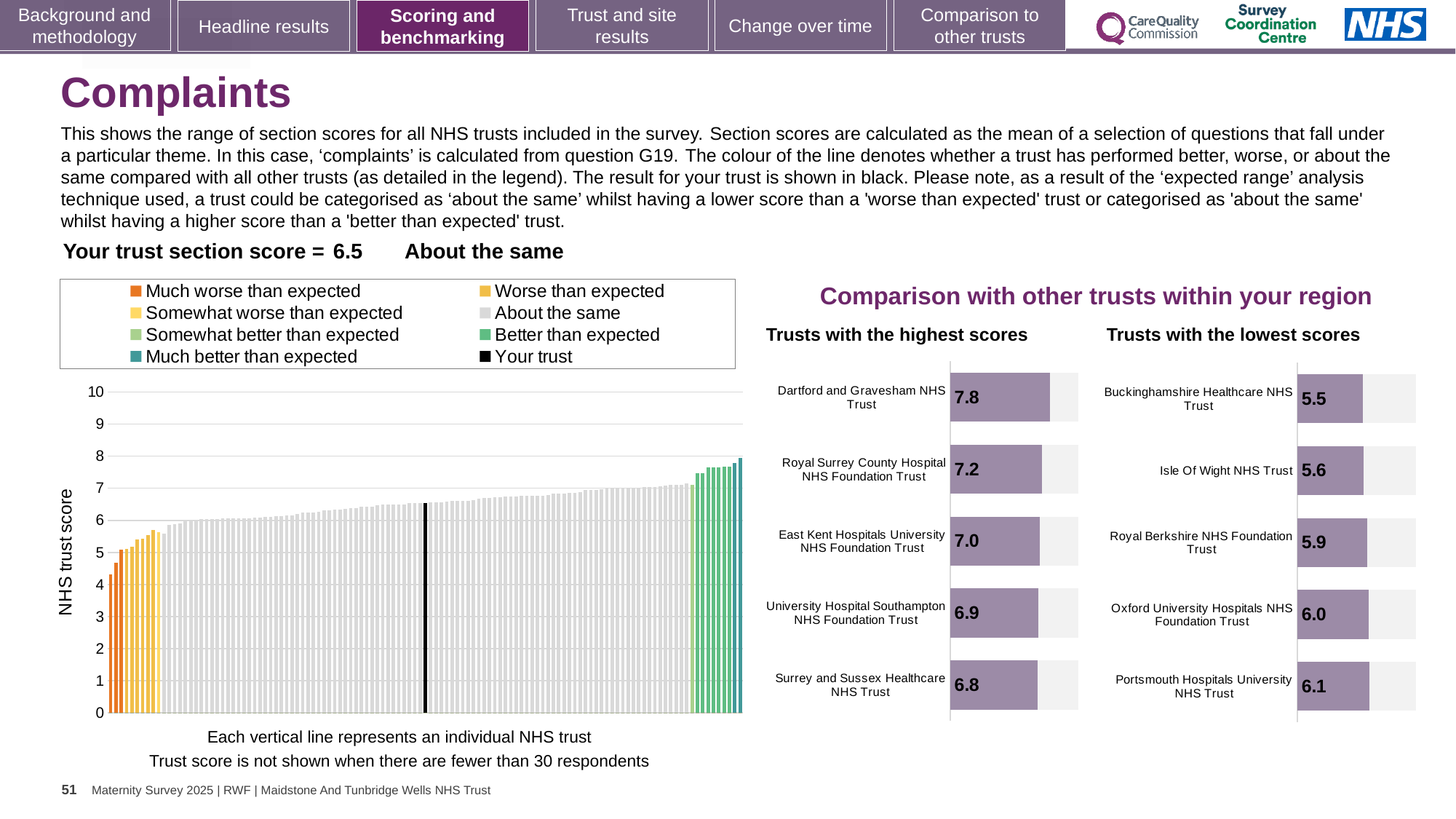
In the 'Trusts with the highest scores' chart, which trust has the highest score? Dartford and Gravesham NHS Trust How many trusts are shown in the 'Trusts with the highest scores' chart? 5 In the 'Trusts with the highest scores' chart, what is the score for Dartford and Gravesham NHS Trust? 7.8 In the 'Trusts with the highest scores' chart, what is the difference between the scores of Dartford and Gravesham NHS Trust and Surrey and Sussex Healthcare NHS Trust? 1.0 In the 'Trusts with the highest scores' chart, which has the higher score: Royal Surrey County Hospital NHS Foundation Trust or East Kent Hospitals University NHS Foundation Trust? Royal Surrey County Hospital NHS Foundation Trust In the 'Trusts with the lowest scores' chart, what is the score for Portsmouth Hospitals University NHS Trust? 6.1 In the large 'NHS trust score' chart on the left, do the bar values rise or fall from left to right? rise How many entries does the legend above the large 'NHS trust score' chart list? 8 What kind of chart is the large 'NHS trust score' chart on the left of the slide? bar chart In the 'Trusts with the lowest scores' chart, what is the score for Isle Of Wight NHS Trust? 5.6 In the 'Trusts with the lowest scores' chart, which trust has the lowest score? Buckinghamshire Healthcare NHS Trust In the 'Trusts with the lowest scores' chart, what is the difference between the scores of Portsmouth Hospitals University NHS Trust and Buckinghamshire Healthcare NHS Trust? 0.6